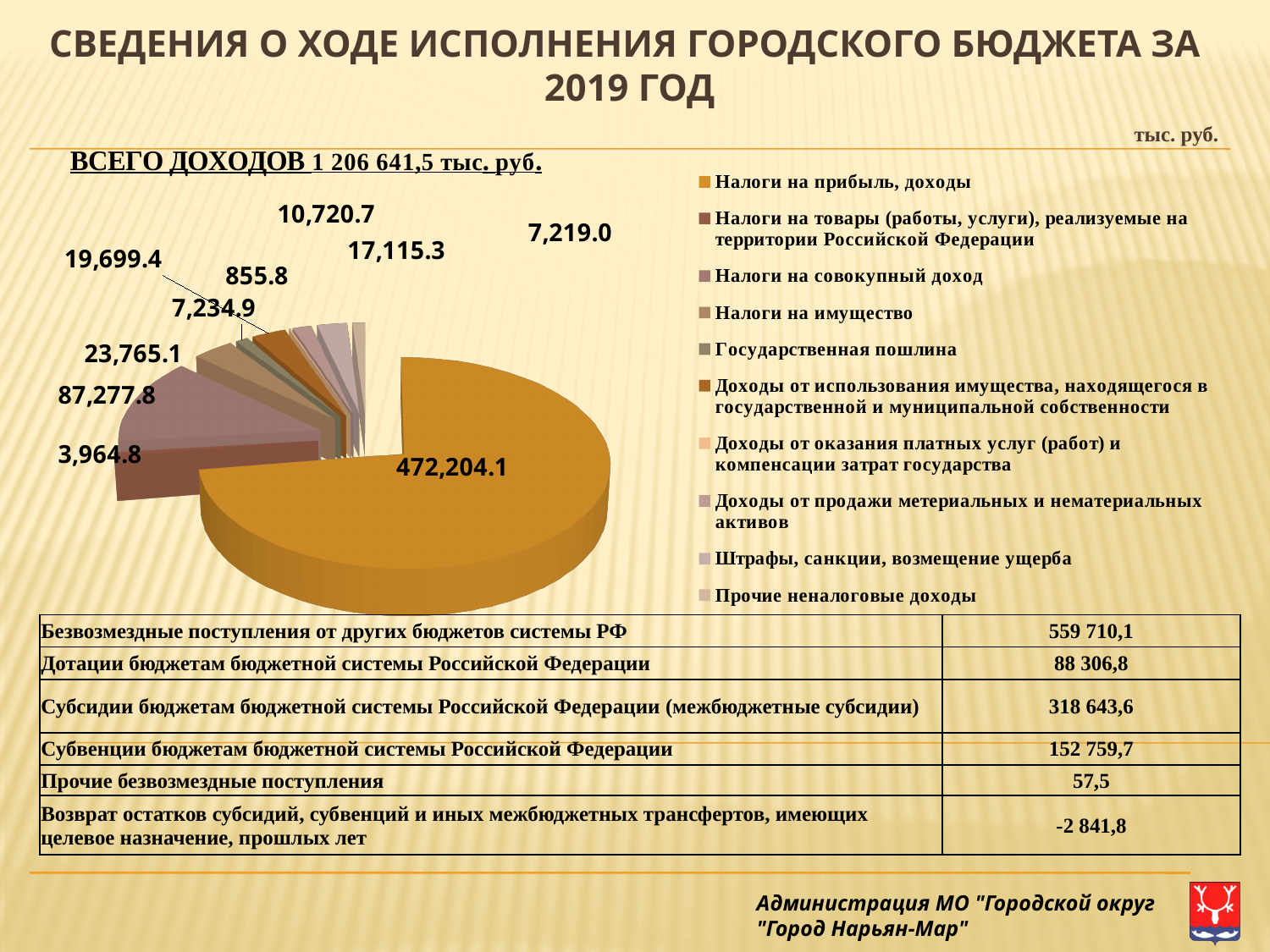
What is the difference between the largest labelled slice (472,204.1) and the second-largest labelled slice (87,277.8)? 384,926.3 What is the smallest value labelled on the pie chart? 855.8 Which category has the largest slice in the pie chart? Налоги на прибыль, доходы What unit is indicated for the values on the slide? тыс. руб. How many slices are labelled with values on the pie chart? 10 What kind of chart is shown on the slide? pie chart How many entries does the legend of the pie chart list? 10 What is the value shown for Налоги на прибыль, доходы in the pie chart? 472,204.1 What is the value of the largest slice in the pie chart? 472,204.1 What total is stated in the heading above the pie chart? 1 206 641,5 тыс. руб.